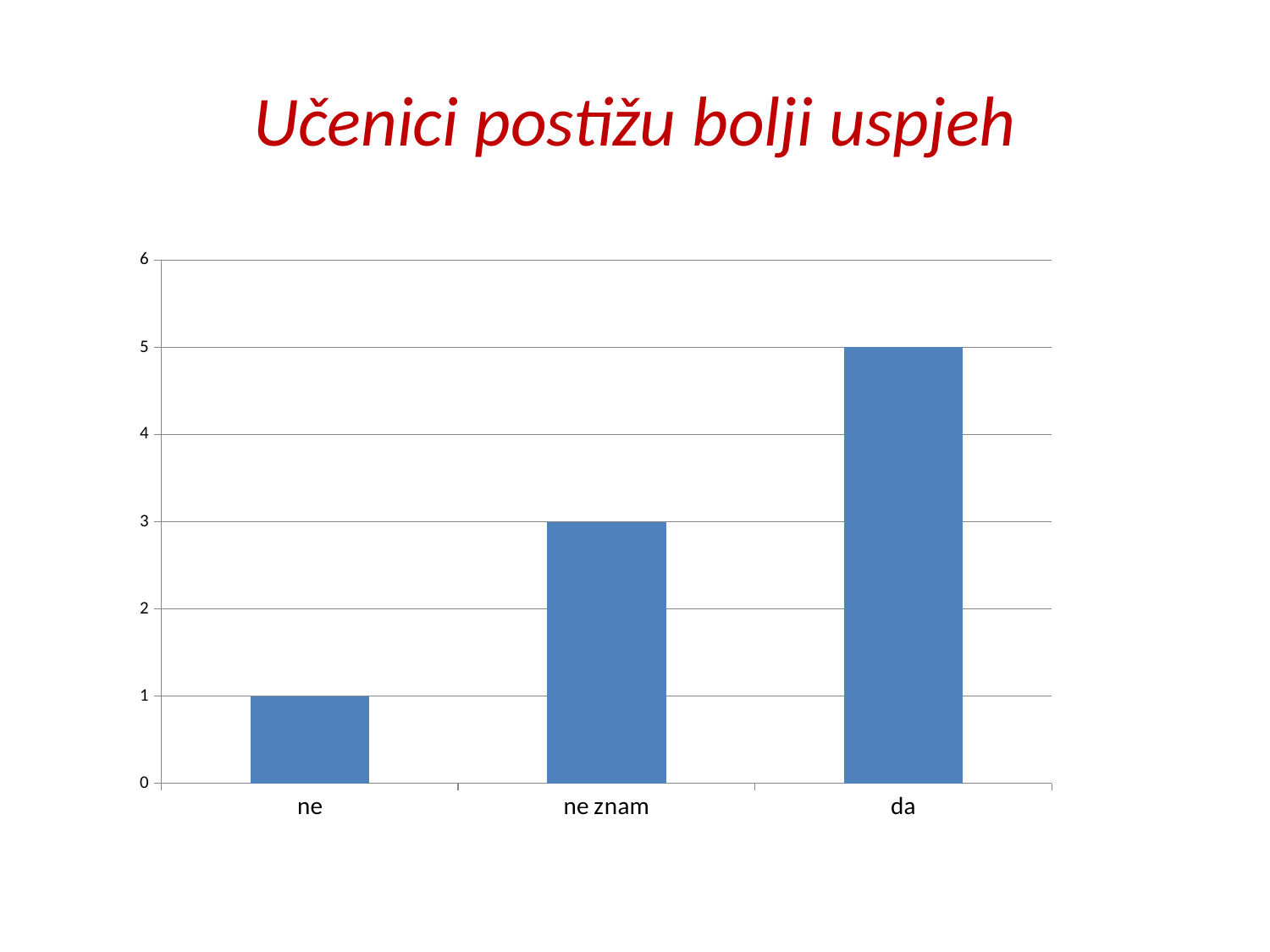
What is the value for "ne znam"? 3 What kind of chart is shown on the slide? bar chart Which is larger, the value for "ne znam" or the value for "da"? da What is the title of the slide? Učenici postižu bolji uspjeh Is the value for "da" greater or less than 4? greater How many categories are shown on the x axis? 3 What is the difference between the values for "ne znam" and "ne"? 2 What is the value for "da"? 5 What is the value for "ne"? 1 What is the difference between the values for "da" and "ne"? 4 Which category has the lowest value? ne Which category has the highest value? da